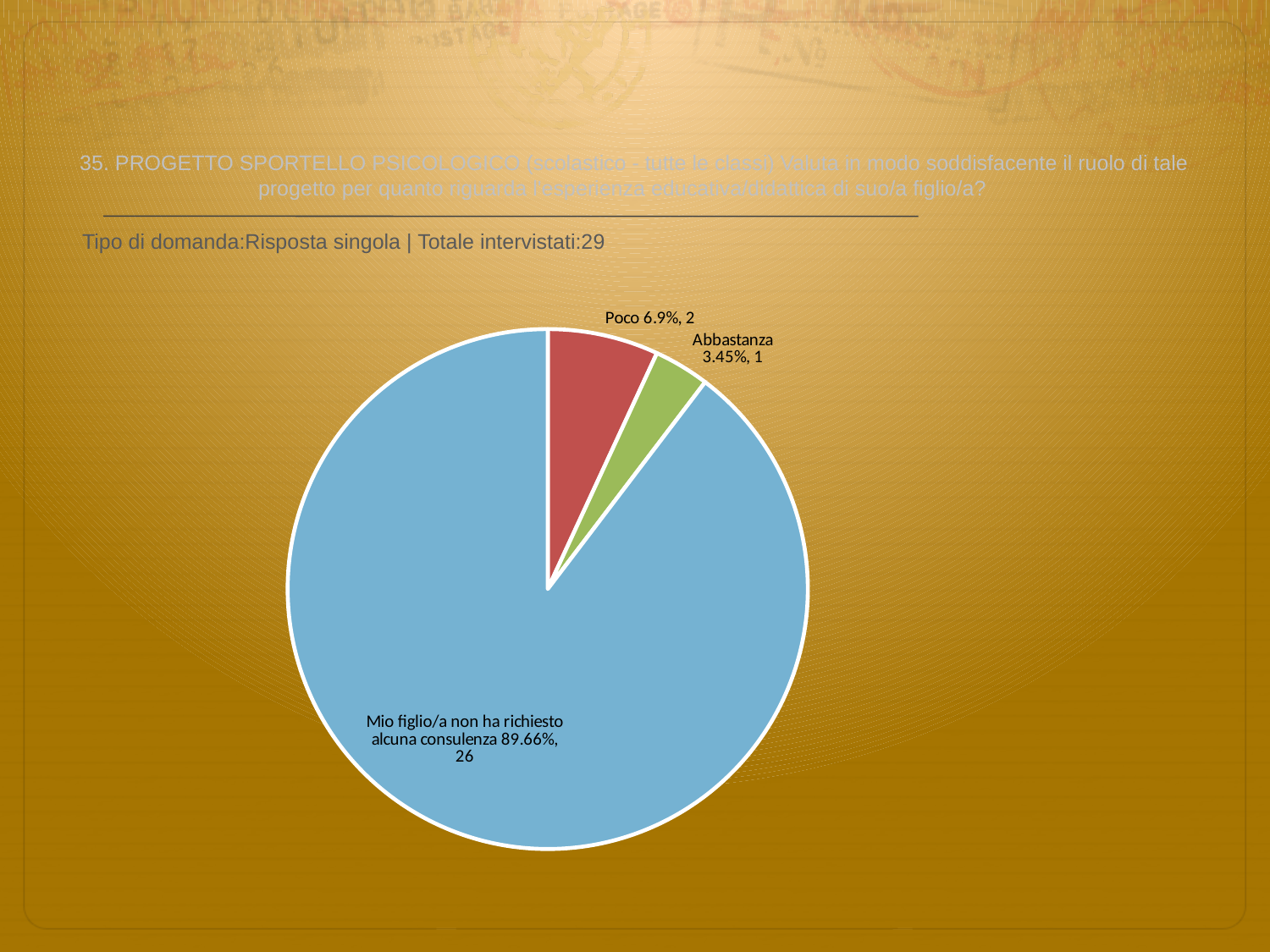
What is the difference in respondent count between 'Poco' and 'Abbastanza'? 1 What percentage share does the 'Poco' slice have? 6.9% Which category has the largest slice? Mio figlio/a non ha richiesto alcuna consulenza How many respondents chose 'Mio figlio/a non ha richiesto alcuna consulenza'? 26 What kind of chart is shown on the slide? pie chart What percentage share does the 'Mio figlio/a non ha richiesto alcuna consulenza' slice have? 89.66% What percentage share does the 'Abbastanza' slice have? 3.45% How many slices does the pie chart have? 3 Which category has the smallest slice? Abbastanza How many respondents chose 'Poco'? 2 Which slice is larger, 'Poco' or 'Abbastanza'? Poco How many respondents chose 'Abbastanza'? 1